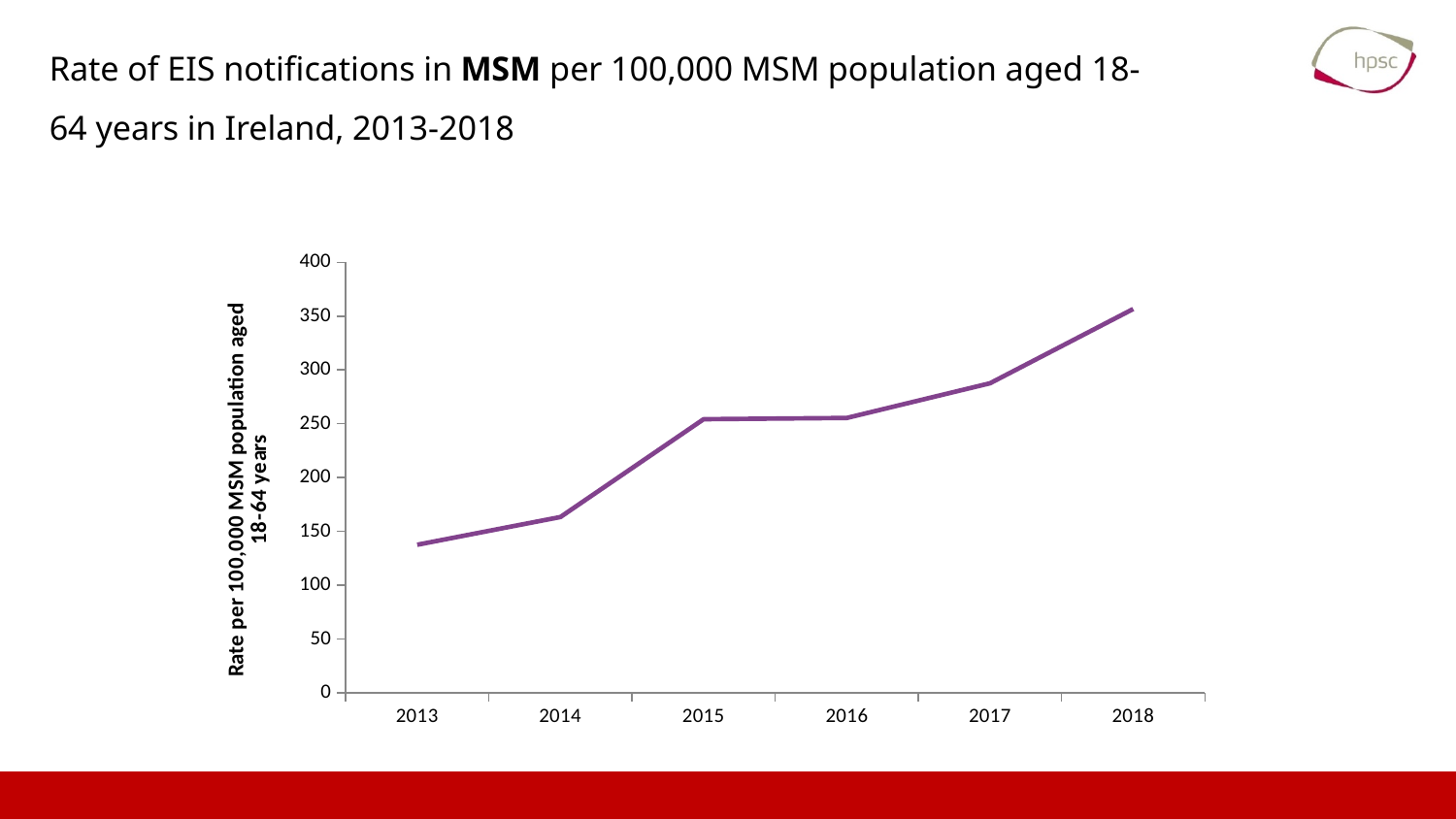
Is the rate for 2018 greater or less than 300? greater What is the label of the y axis? Rate per 100,000 MSM population aged 18-64 years Which year has the lowest rate of EIS notifications in MSM? 2013 How many years are plotted on the x axis? 6 Is the rate for 2015 greater or less than 200? greater Is the rate for 2014 greater or less than 150? greater Does the rate of EIS notifications in MSM generally rise or fall from 2013 to 2018? rise Which year has the higher rate, 2014 or 2017? 2017 What kind of chart is shown on the slide? line chart Which year has the highest rate of EIS notifications in MSM? 2018